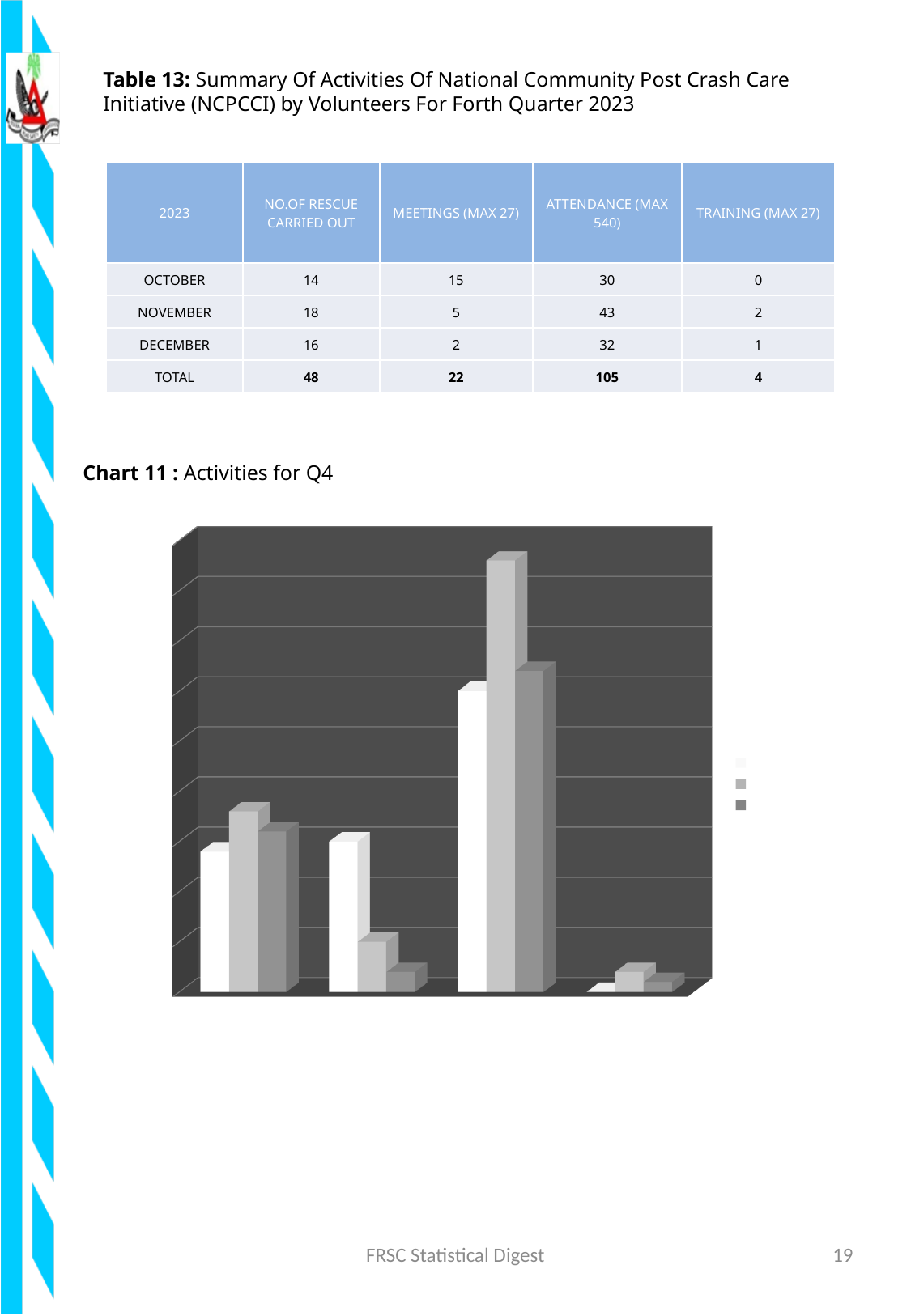
What kind of chart is Chart 11? bar chart How many series does the legend of Chart 11 list? 3 In Chart 11, which group of bars from the left contains the tallest bar? third What colours are the three series in Chart 11? white, light grey and dark grey In Chart 11, which group of bars from the left has the shortest bars overall? fourth How many groups of bars are plotted in Chart 11? 4 What is the title of the chart on the slide? Chart 11 : Activities for Q4